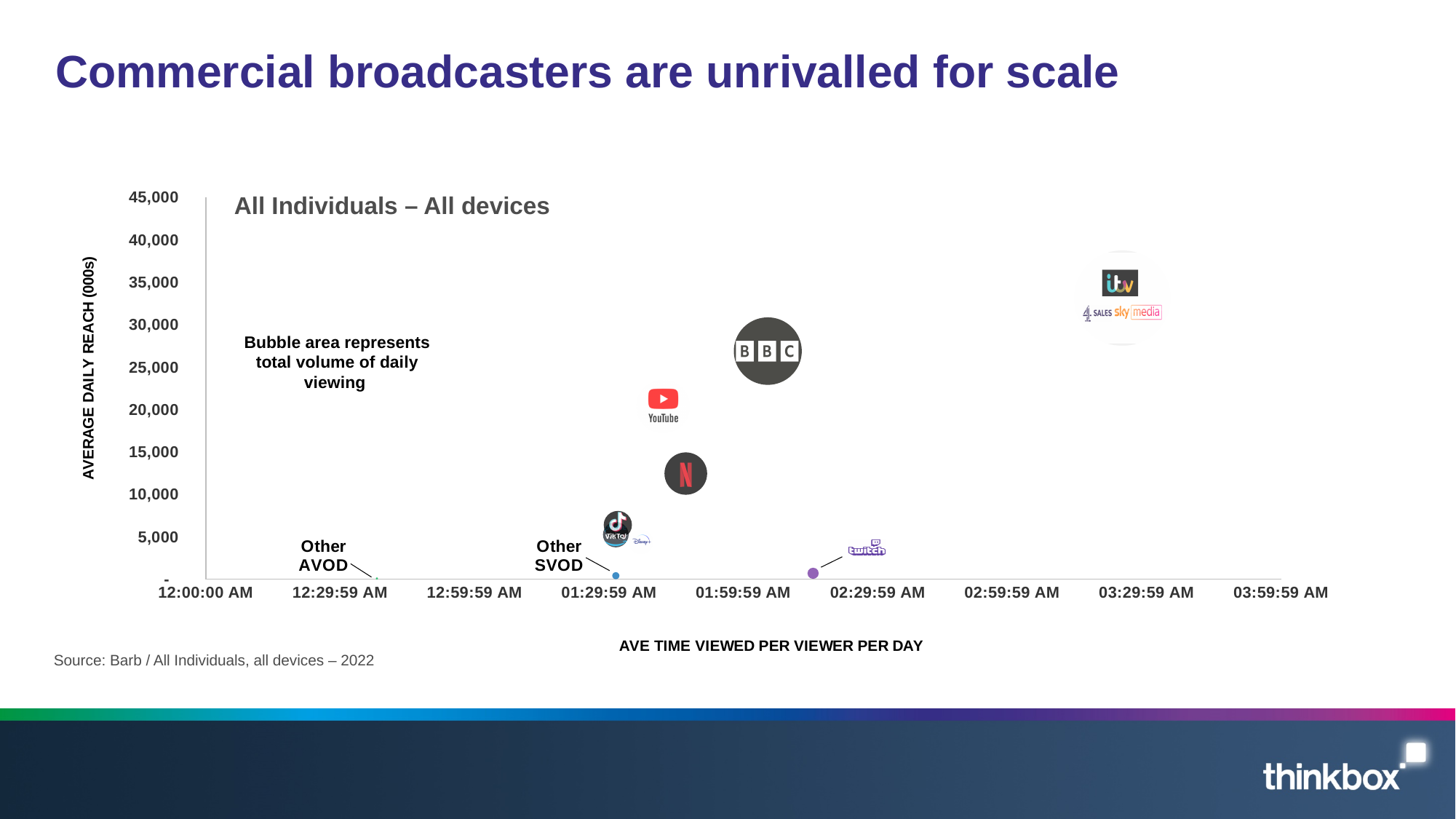
Is the average daily reach for Netflix greater or less than 15,000? less Is the average daily reach for TikTok greater or less than 10,000? less Is the average daily reach for Twitch greater or less than 5,000? less Which bubble has the highest average daily reach? ITV / Channel 4 / Sky Media (commercial broadcasters) What kind of chart is shown on the slide? Bubble chart What does the vertical axis of the chart measure? AVERAGE DAILY REACH (000s) What is the title printed inside the chart area? All Individuals – All devices Which has the higher average daily reach, BBC or YouTube? BBC